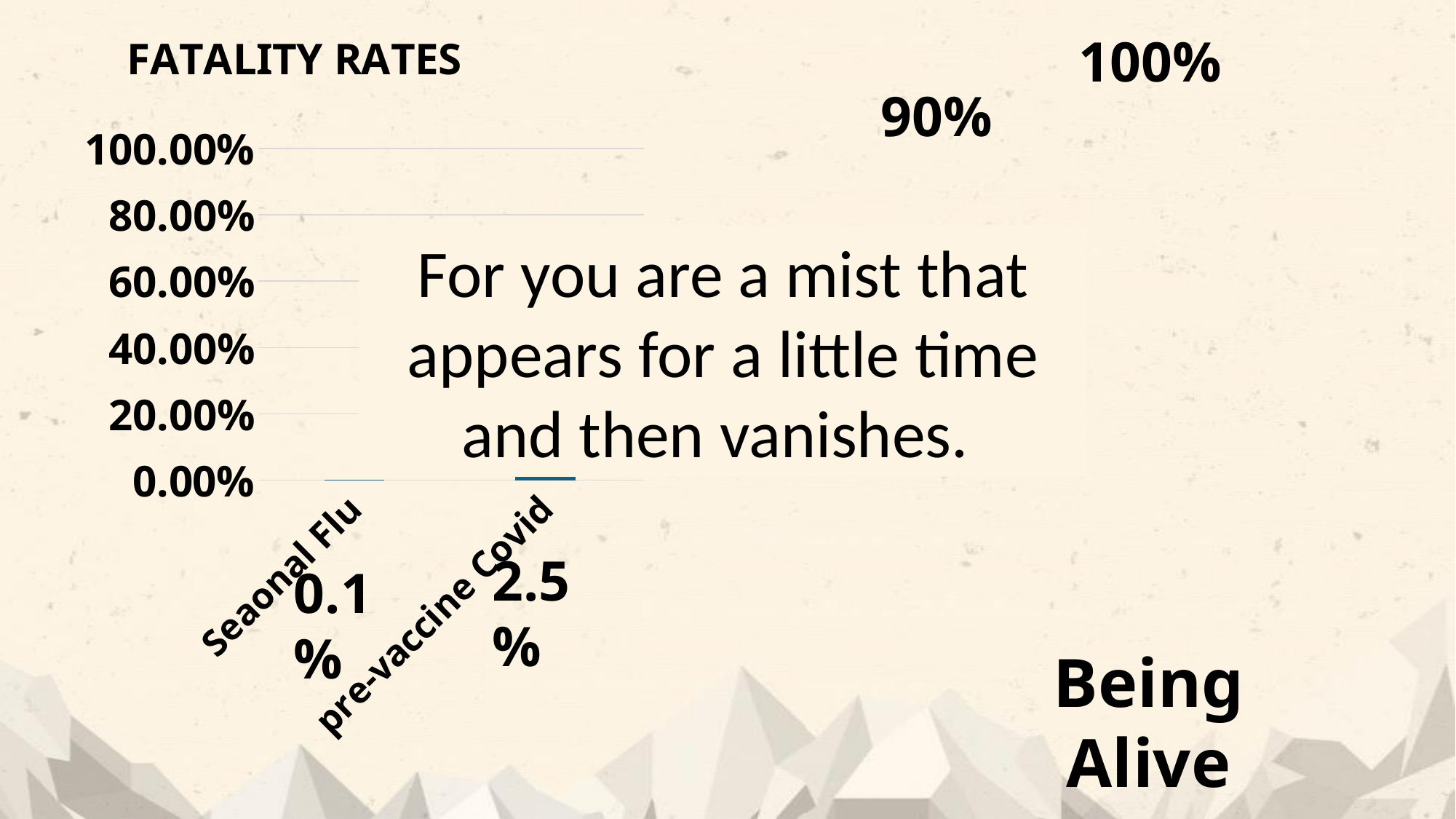
Which category has the higher fatality rate, Seaonal Flu or pre-vaccine Covid? pre-vaccine Covid What kind of chart is shown on the slide? bar chart How many categories are shown on the x axis of the chart? 2 What is the highest tick value shown on the y axis of the chart? 100.00% Which category has the lowest fatality rate in the chart? Seaonal Flu Do the values rise or fall from Seaonal Flu to pre-vaccine Covid along the x axis? rise What is the difference between the labelled fatality rates for pre-vaccine Covid and Seaonal Flu? 2.4% What fatality rate is labelled for Seaonal Flu? 0.1% What is the title of the chart? FATALITY RATES Is the value for pre-vaccine Covid greater or less than 20.00%? less What fatality rate is labelled for pre-vaccine Covid? 2.5%